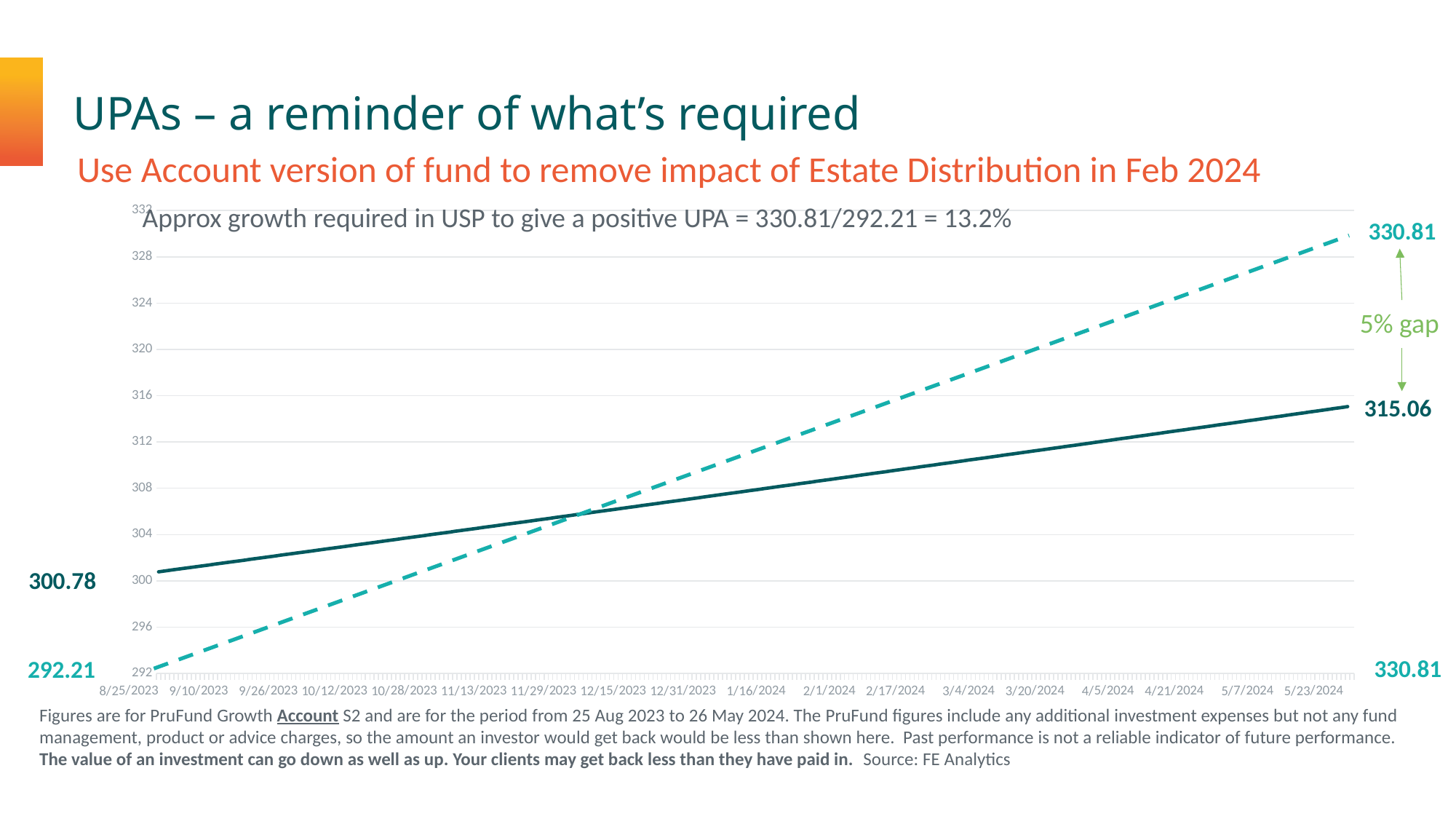
By how much does the solid line rise from its start (300.78) to its end (315.06)? 14.28 What gap is labelled between the two lines at the right-hand end of the chart? 5% gap What kind of chart is shown on the slide? line chart What is the starting value of the dashed line on the chart? 292.21 What is the starting value of the solid dark line on the chart? 300.78 What is the ending value of the dashed line on the chart? 330.81 What is the ending value of the solid dark line on the chart? 315.06 At the end of the period, which line is higher: the dashed line or the solid line? the dashed line At the start of the period, which line is higher: the dashed line or the solid line? the solid line Do the values of the solid line rise or fall across the x axis? rise What is the difference between the ending values of the dashed line (330.81) and the solid line (315.06)? 15.75 How many lines are plotted on the chart? 2